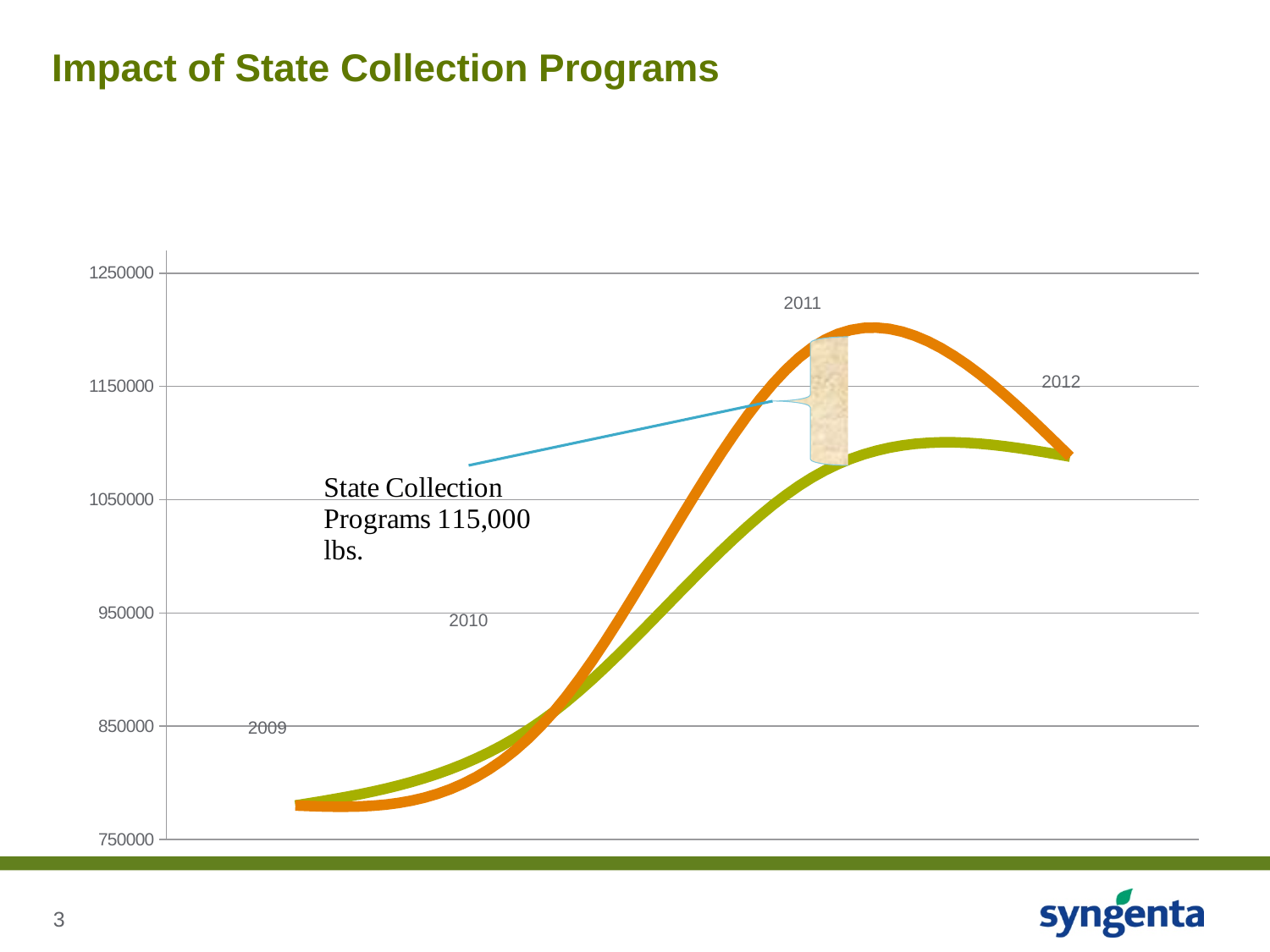
Do the values of the green line rise or fall from 2009 to 2011? rise In which year does the orange line reach its highest value? 2011 What kind of chart is shown on the slide? line chart In 2011, which line is higher, the orange line or the green line? orange In which year does the orange line have its lowest value? 2009 Is the value of the green line in 2011 greater or less than 1150000? less Is the value of the orange line in 2011 greater or less than 1150000? greater What is the title of the slide containing the chart? Impact of State Collection Programs How many years are labelled along the chart's lines? 4 Is the value of the orange line in 2009 greater or less than 850000? less How many lines are plotted on the chart? 2